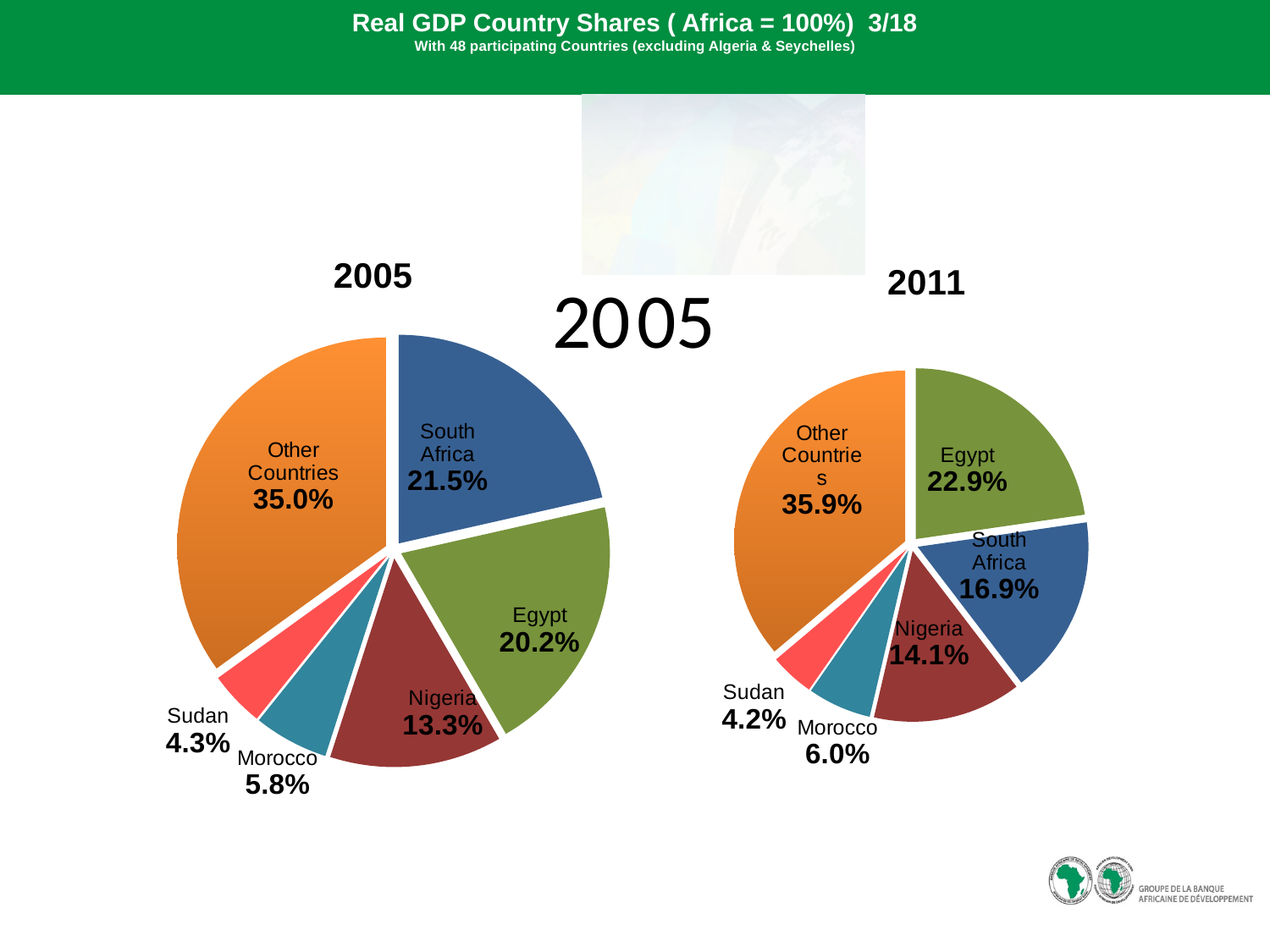
In the 2005 pie chart, which named country (excluding Other Countries) has the largest share? South Africa In the 2011 pie chart, what share does Nigeria have? 14.1% In the 2011 pie chart, which slice is the smallest? Sudan In the 2011 pie chart, what share does Egypt have? 22.9% How many slices does the 2011 pie chart have? 6 In the 2011 pie chart, which is larger, South Africa or Nigeria? South Africa In the 2005 pie chart, what share does Morocco have? 5.8% In the 2005 pie chart, what share does South Africa have? 21.5% In the 2005 pie chart, what is the difference between the shares of South Africa and Egypt? 1.3% In the 2005 pie chart, which slice is the largest? Other Countries In the 2011 pie chart, what is the difference between the shares of Morocco and Sudan? 1.8% What type of chart is used to show the 2005 data? Pie chart